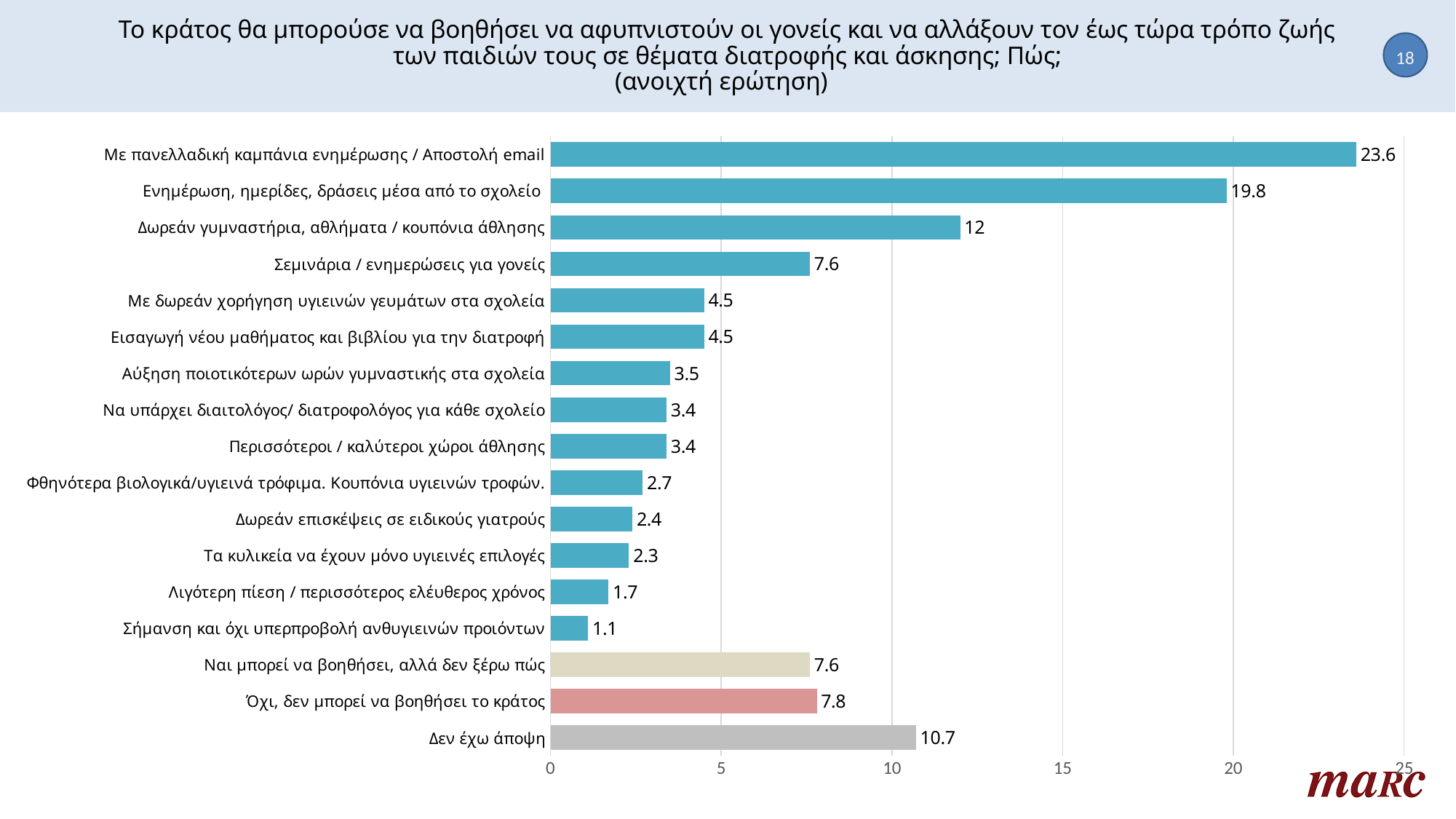
How many categories are shown in the chart? 17 What is the difference between the values for "Με πανελλαδική καμπάνια ενημέρωσης / Αποστολή email" and "Ενημέρωση, ημερίδες, δράσεις μέσα από το σχολείο"? 3.8 Which category has the highest value? Με πανελλαδική καμπάνια ενημέρωσης / Αποστολή email What is the value for "Όχι, δεν μπορεί να βοηθήσει το κράτος"? 7.8 What kind of chart is shown on the slide? bar chart What is the value for "Με πανελλαδική καμπάνια ενημέρωσης / Αποστολή email"? 23.6 Is the value for "Ενημέρωση, ημερίδες, δράσεις μέσα από το σχολείο" greater or less than 20? less Which category has the lowest value? Σήμανση και όχι υπερπροβολή ανθυγιεινών προιόντων What colour is the bar for "Όχι, δεν μπορεί να βοηθήσει το κράτος"? red What is the value for "Δεν έχω άποψη"? 10.7 Which is larger: the value for "Σεμινάρια / ενημερώσεις για γονείς" or the value for "Δεν έχω άποψη"? Δεν έχω άποψη What is the value for "Δωρεάν γυμναστήρια, αθλήματα / κουπόνια άθλησης"? 12